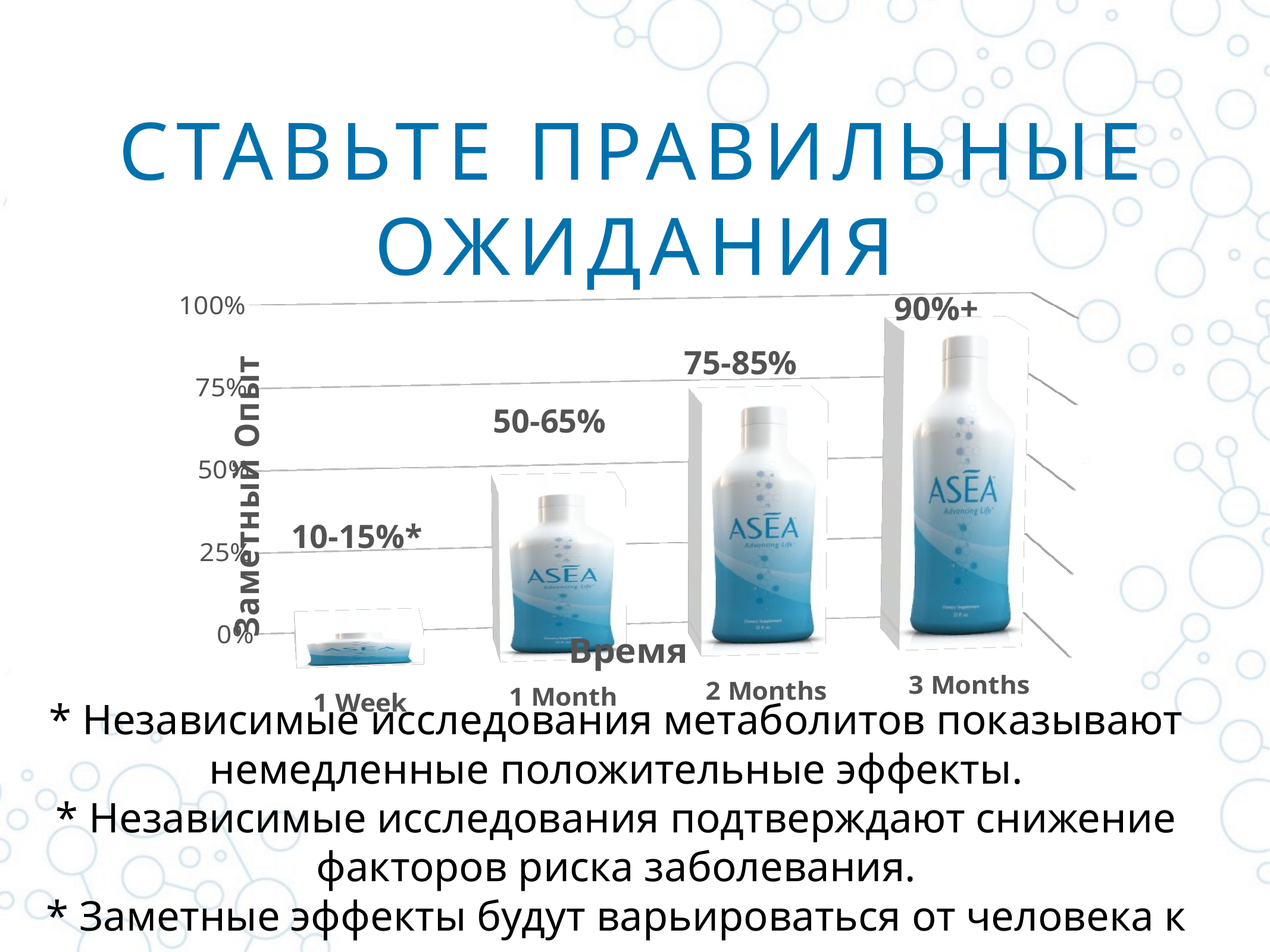
What data label is shown for the 2 Months bar? 75-85% What data label is shown for the 1 Month bar? 50-65% How many categories are shown on the x axis? 4 Which category has the highest bar? 3 Months What data label is shown for the 1 Week bar? 10-15%* Which category has the lowest bar? 1 Week What data label is shown for the 3 Months bar? 90%+ Which is larger, the value for 1 Month or the value for 2 Months? 2 Months Is the value for 1 Week greater or less than 25%? less What kind of chart is shown on the slide? Bar chart Do the bar values rise or fall from 1 Week to 3 Months? Rise What is the title of the x axis? Время